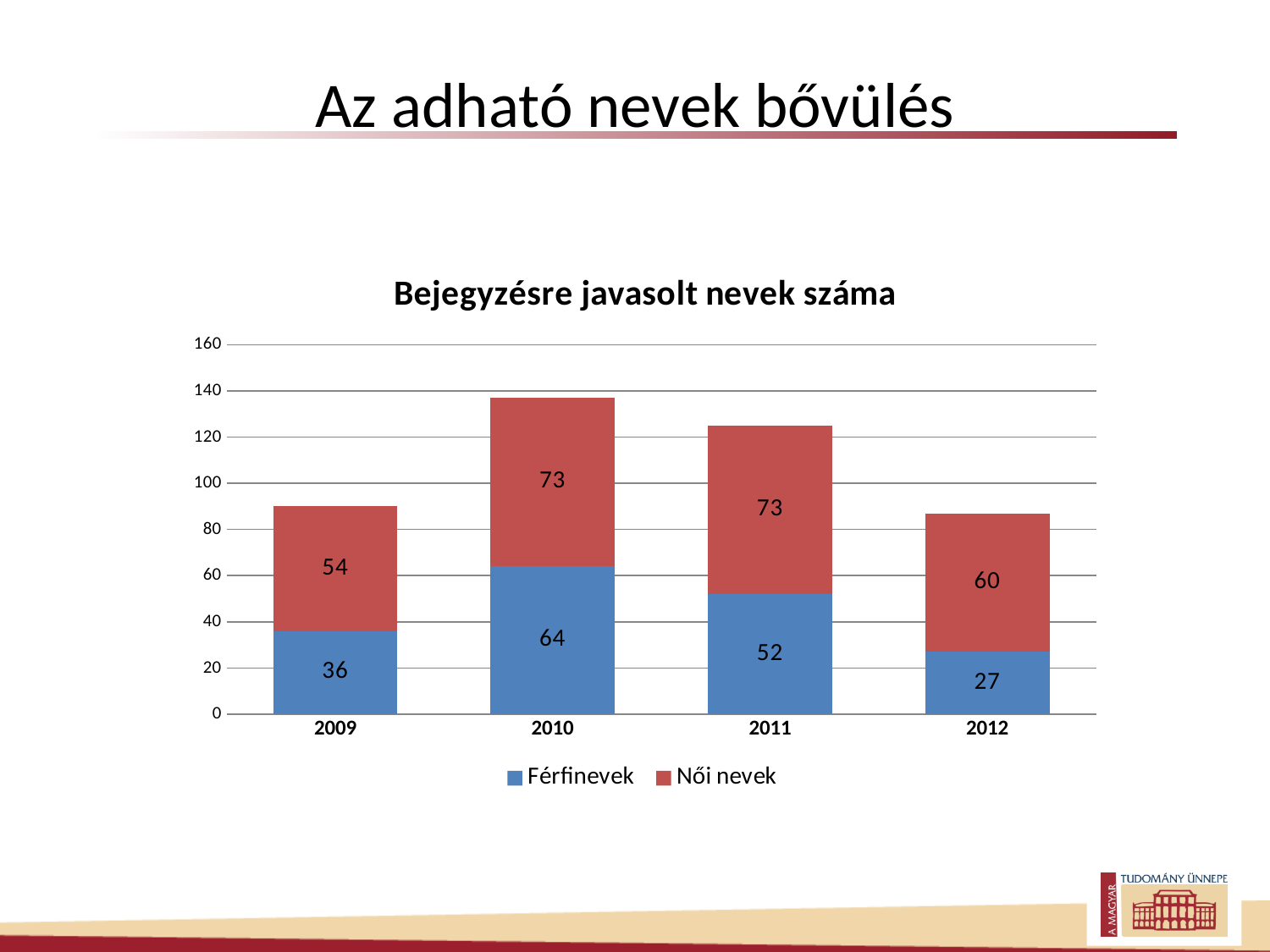
Which year has the lowest value for Férfinevek? 2012 Which year has the highest value for Férfinevek? 2010 What is the total of the stacked bar for 2010? 137 What is the value for Férfinevek in 2009? 36 What kind of chart is shown on the slide? Stacked bar chart What is the value for Női nevek in 2012? 60 What is the value for Férfinevek in 2010? 64 How many series does the legend list? 2 How many years are shown on the x axis? 4 Which is larger, the Férfinevek value for 2011 or for 2012? 2011 What is the total of the stacked bar for 2009? 90 What is the difference between the Női nevek values for 2011 and 2012? 13